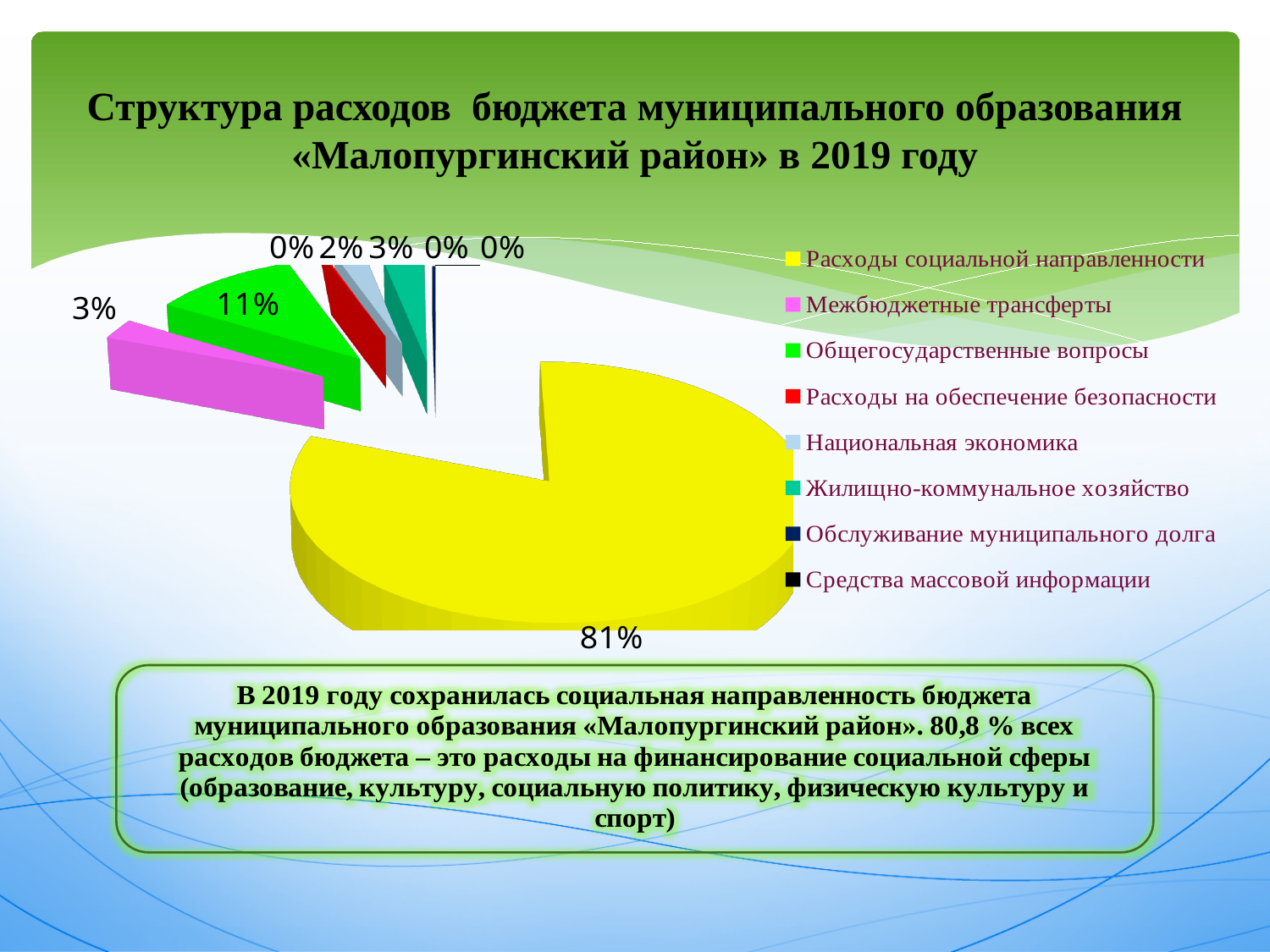
What is the value shown for «Общегосударственные вопросы»? 11% What is the value shown for «Межбюджетные трансферты»? 3% What is the difference in percentage points between «Общегосударственные вопросы» and «Межбюджетные трансферты»? 8 Which is larger: «Общегосударственные вопросы» or «Межбюджетные трансферты»? Общегосударственные вопросы Which category has the largest slice of the pie? Расходы социальной направленности What is the difference in percentage points between «Расходы социальной направленности» and «Общегосударственные вопросы»? 70 What share of the pie does «Расходы социальной направленности» take? 81% Which colour represents «Расходы социальной направленности» in the legend? yellow How many categories does the legend list? 8 Which year does the chart title refer to? 2019 What kind of chart is shown on the slide? pie chart